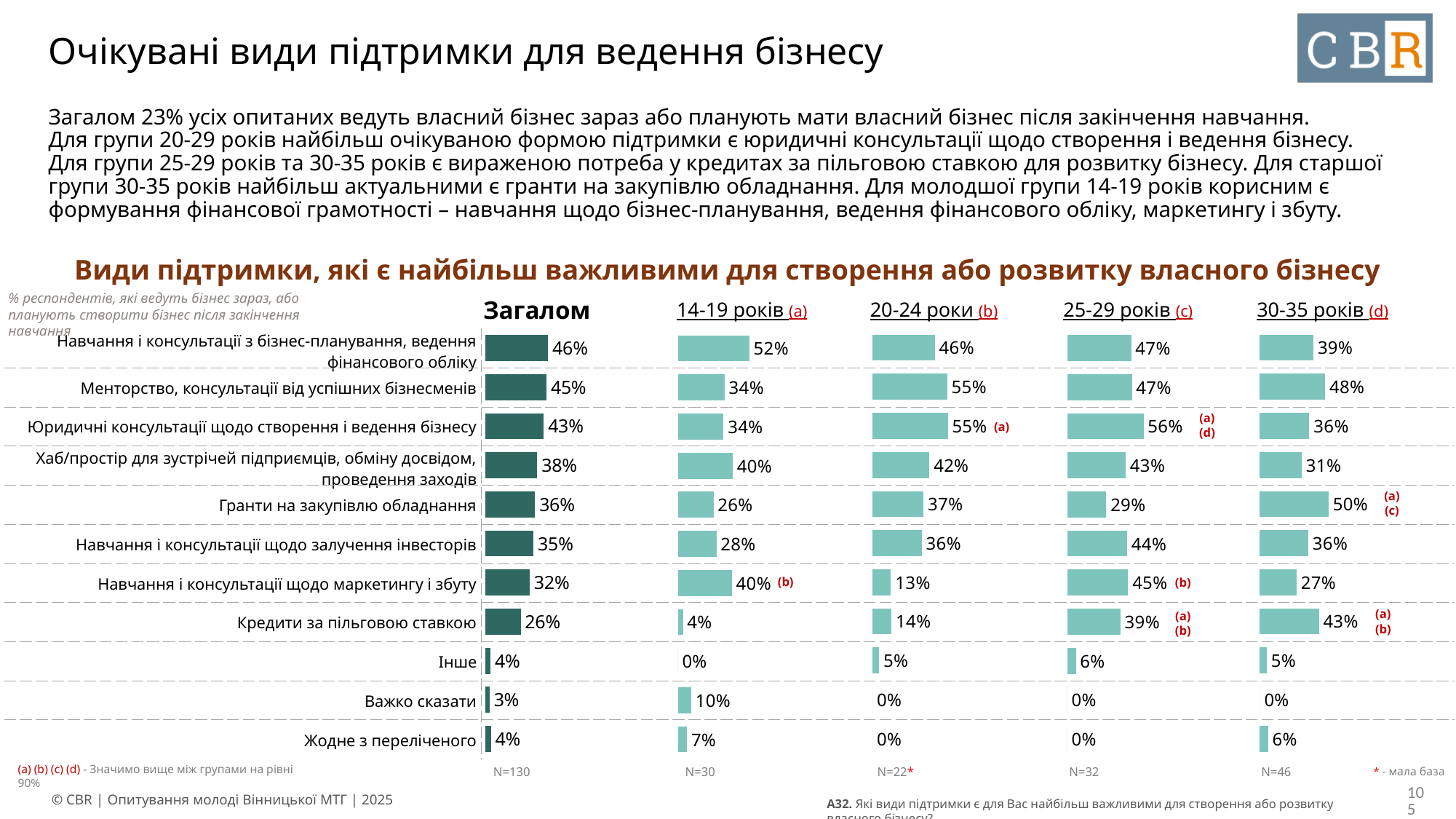
In the '20-24 роки' column, what is the value for 'Навчання і консультації щодо маркетингу і збуту'? 13% What is the sample size (N) shown for the '20-24 роки' column? N=22 In the '14-19 років' column, which category has the highest value? Навчання і консультації з бізнес-планування, ведення фінансового обліку What type of chart is used on this slide? Bar chart How many age-group columns (excluding 'Загалом') are shown in the chart? 4 In the '30-35 років' column, which category has the highest value? Гранти на закупівлю обладнання In the 'Загалом' column, what is the value for 'Гранти на закупівлю обладнання'? 36% In the '30-35 років' column, what is the value for 'Кредити за пільговою ставкою'? 43% For 'Менторство, консультації від успішних бізнесменів', which is larger: the '20-24 роки' value or the '14-19 років' value? 20-24 роки In the 'Загалом' column, which category has the lowest value? Важко сказати How many categories (rows) are shown in the chart? 11 What is the difference between the '25-29 років' and '14-19 років' values for 'Кредити за пільговою ставкою'? 35 percentage points